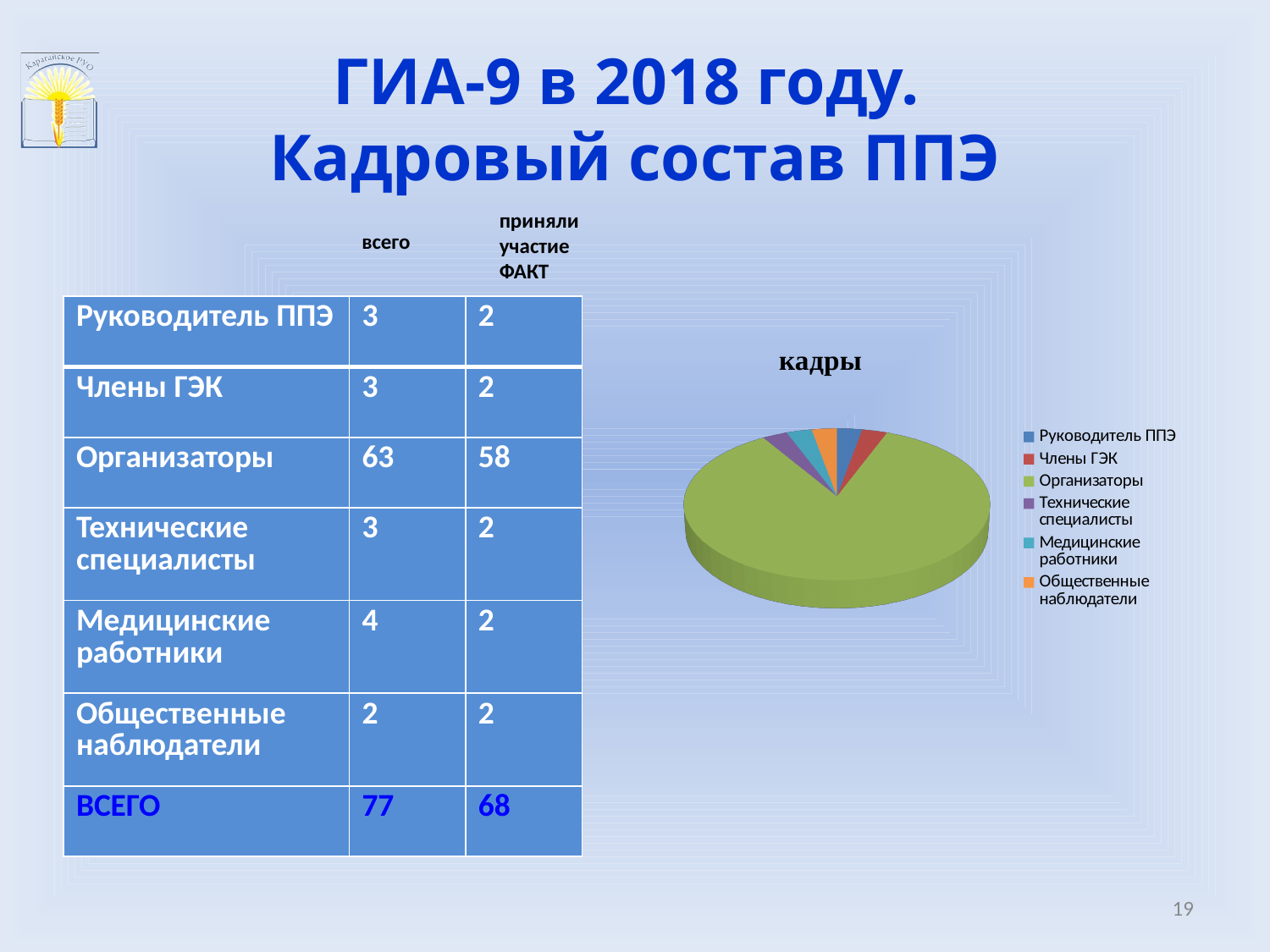
What colour is the Организаторы slice in the pie chart? green Which slice is larger in the pie chart, Организаторы or Общественные наблюдатели? Организаторы How many categories does the pie chart's legend list? 6 Which slice is larger in the pie chart, Организаторы or Руководитель ППЭ? Организаторы Does the Организаторы slice take up more or less than half of the pie chart? more Which slice is larger in the pie chart, Организаторы or Члены ГЭК? Организаторы What kind of chart is shown on the slide? pie chart What is the title of the pie chart? кадры Which category has the largest slice in the pie chart? Организаторы